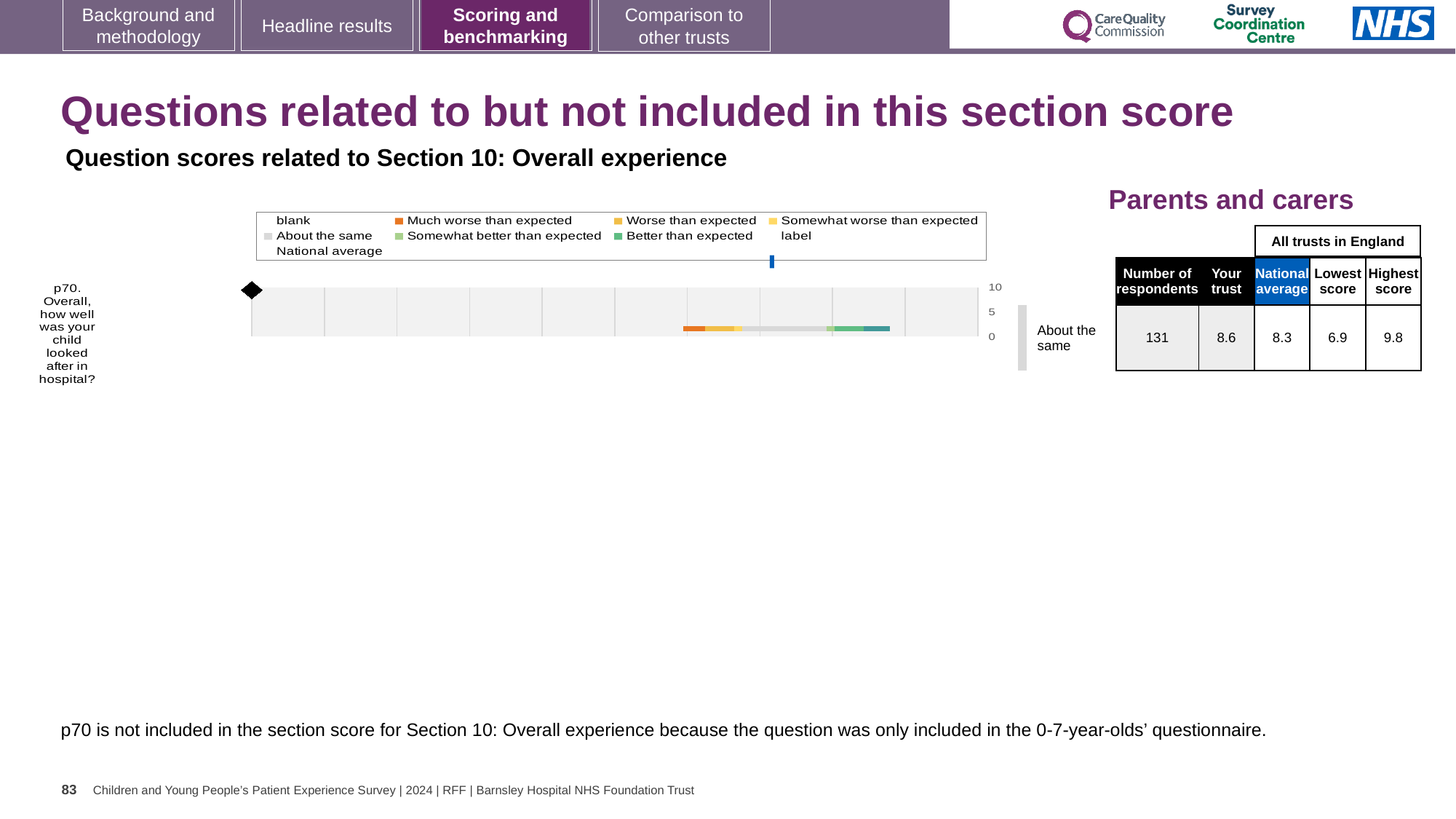
Which question is plotted in the chart? p70. Overall, how well was your child looked after in hospital? In the table, what is the highest score among all trusts in England for p70? 9.8 In the table, what is the 'Your trust' score for p70? 8.6 In the table, what is the number of respondents for p70? 131 In the table, what is the lowest score among all trusts in England for p70? 6.9 Is the 'Your trust' score for p70 larger or smaller than the national average? larger What is the difference between the highest score and the lowest score for p70 in the table? 2.9 What is the highest value shown on the chart's axis? 10 In the table, what is the national average score for p70? 8.3 What kind of chart is shown on the slide? bar chart How many questions are plotted in the chart? 1 What category label is shown to the right of the bar for p70? About the same